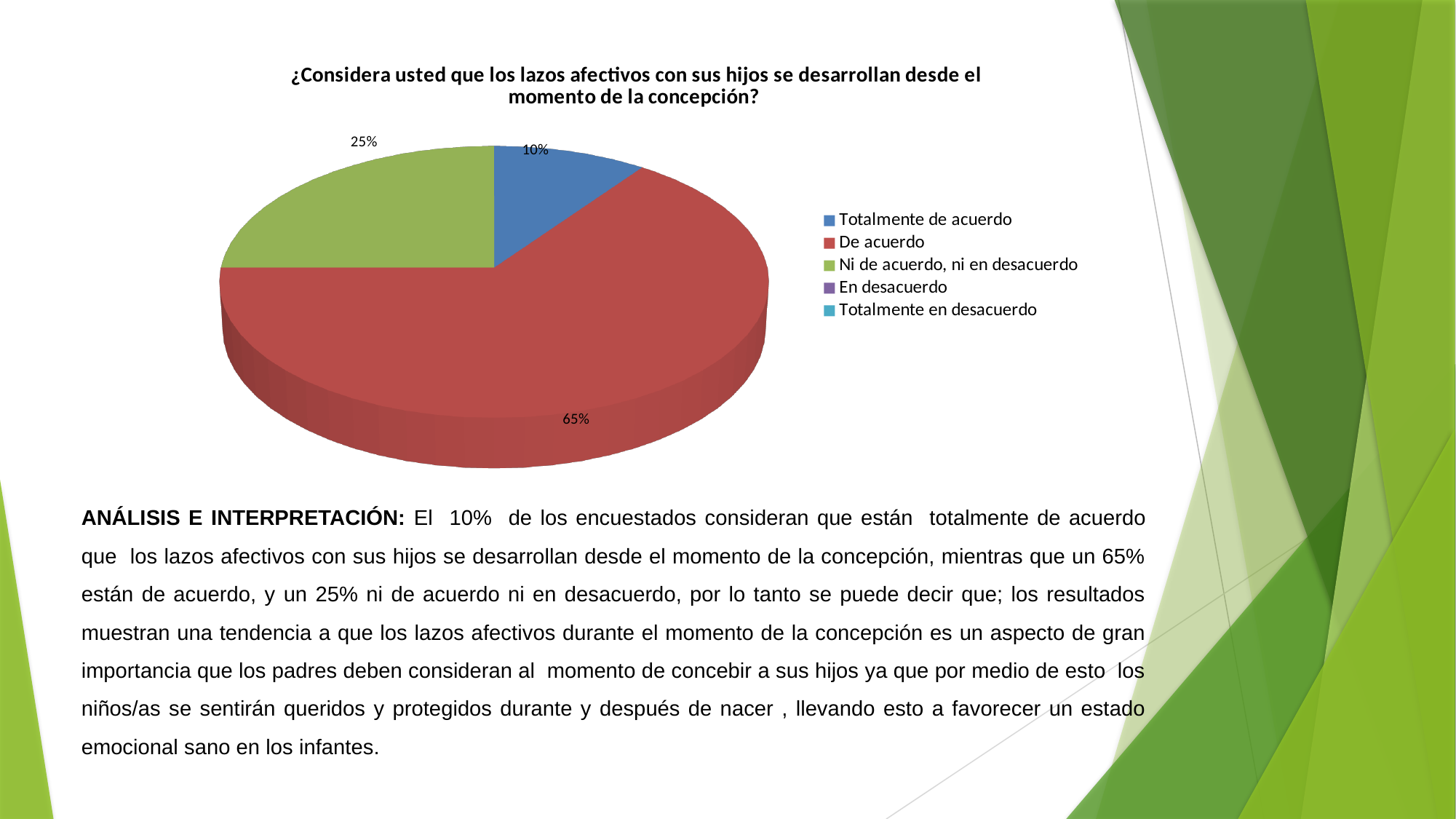
Which response category has the largest share of the pie? De acuerdo What percentage of respondents answered "Totalmente de acuerdo"? 10% How many entries does the legend list? 5 What colour is the slice for "De acuerdo"? Red How many slices with data labels are visible in the pie? 3 Which is larger, the share for "Ni de acuerdo, ni en desacuerdo" or the share for "Totalmente de acuerdo"? Ni de acuerdo, ni en desacuerdo What is the title of the chart? ¿Considera usted que los lazos afectivos con sus hijos se desarrollan desde el momento de la concepción? What is the difference in percentage points between "De acuerdo" and "Ni de acuerdo, ni en desacuerdo"? 40 Which of the labelled slices has the smallest share of the pie? Totalmente de acuerdo What percentage of respondents answered "Ni de acuerdo, ni en desacuerdo"? 25% What percentage of respondents answered "De acuerdo"? 65% What kind of chart is shown on the slide? Pie chart